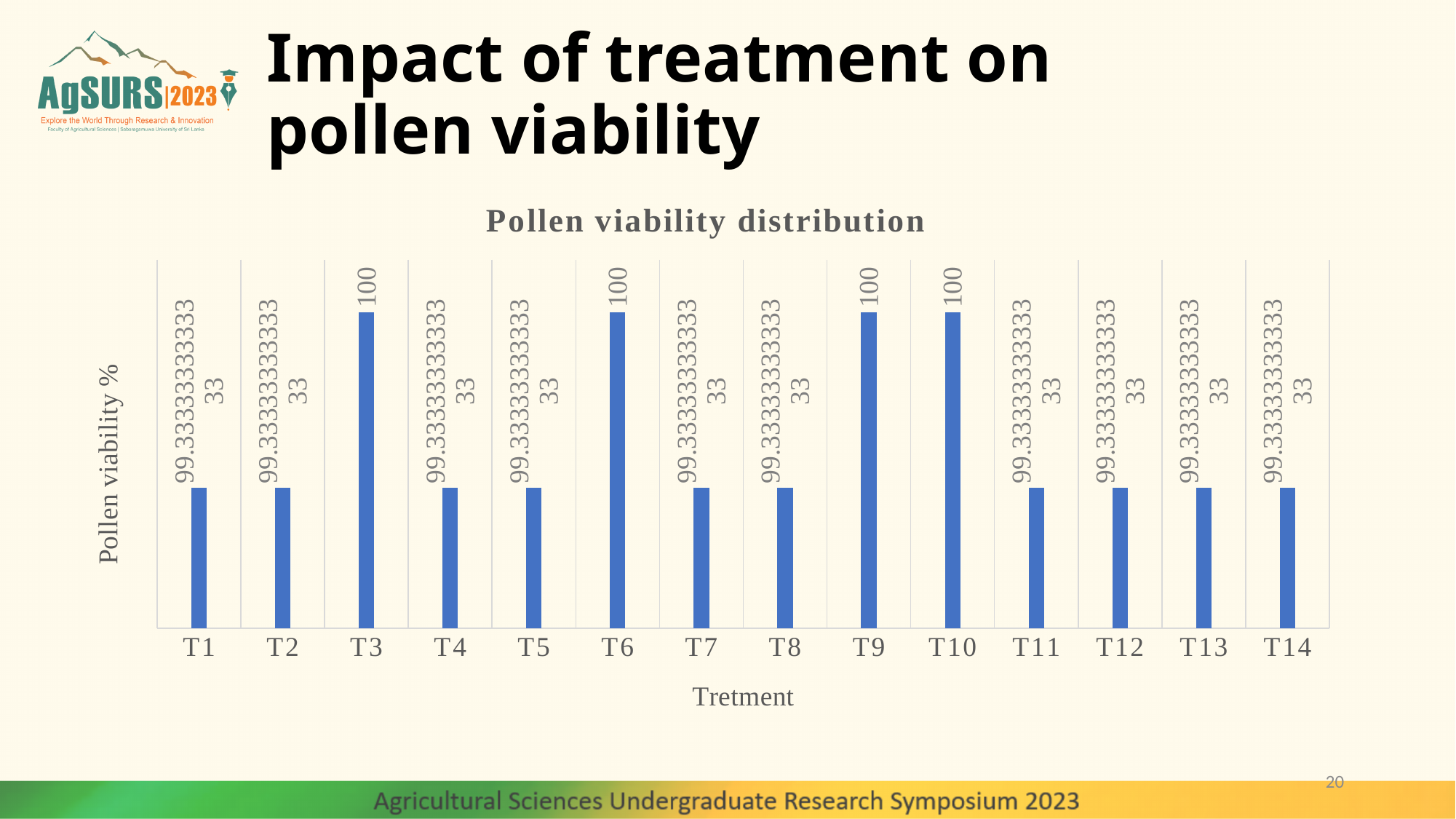
What is the title of the chart? Pollen viability distribution Which has the larger pollen viability value, T1 or T3? T3 What is the pollen viability value for T9? 100 What is the label of the y axis? Pollen viability % What type of chart is shown on the slide? bar chart How many treatments are plotted on the x axis of the chart? 14 What is the pollen viability value for T6? 100 Which treatments have the highest pollen viability value? T3, T6, T9, T10 Which has the larger pollen viability value, T10 or T11? T10 How many treatments reach a pollen viability of 100? 4 What is the pollen viability value for T3? 100 Is the value for T14 greater or less than 100? less